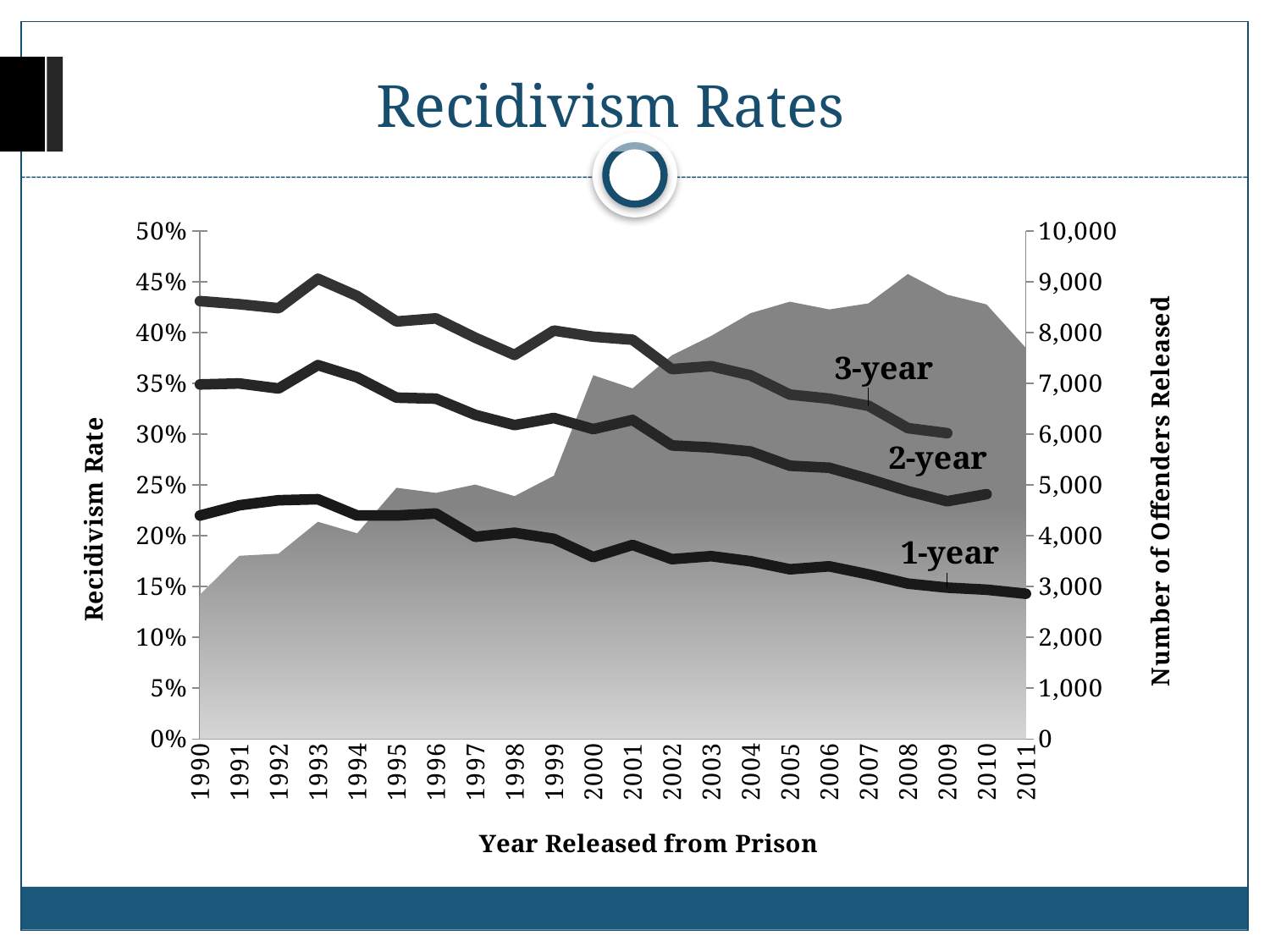
Is the number of offenders released in 2008 greater or less than 8,000? greater Is the 2-year recidivism rate for 2009 greater or less than 25%? less In which year is the number of offenders released highest? 2008 How many years are shown along the x axis? 22 Is the 1-year recidivism rate for 2005 greater or less than 20%? less Does the 3-year recidivism rate generally rise or fall from 1990 to 2009? fall In which year is the 3-year recidivism rate highest? 1993 What is the title of the chart? Recidivism Rates What is the label of the left vertical axis? Recidivism Rate How many labelled line series are plotted on the chart? 3